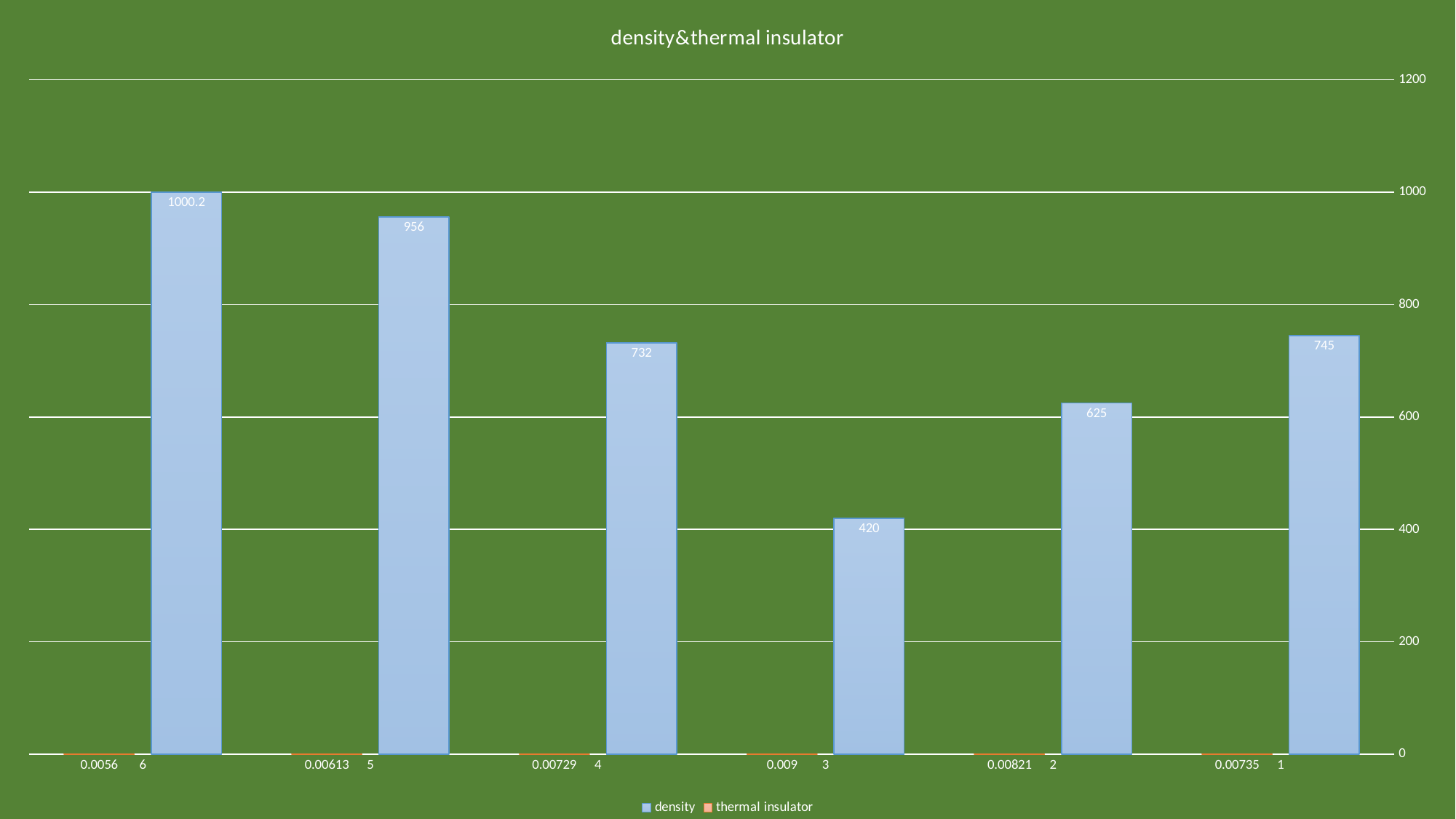
How many series does the legend list? 2 How many categories are shown on the x axis? 6 What type of chart is shown on the slide? bar chart What is the density value for category 3? 420 What is the density value for category 6? 1000.2 Which category has the lowest density value? 3 What is the thermal insulator value for category 4? 0.00729 What is the title of the chart? density&thermal insulator Which has a larger density value, category 4 or category 1? category 1 Which category has the highest density value? 6 What is the difference between the density values for category 5 and category 2? 331 Is the density value for category 2 greater or less than 600? greater